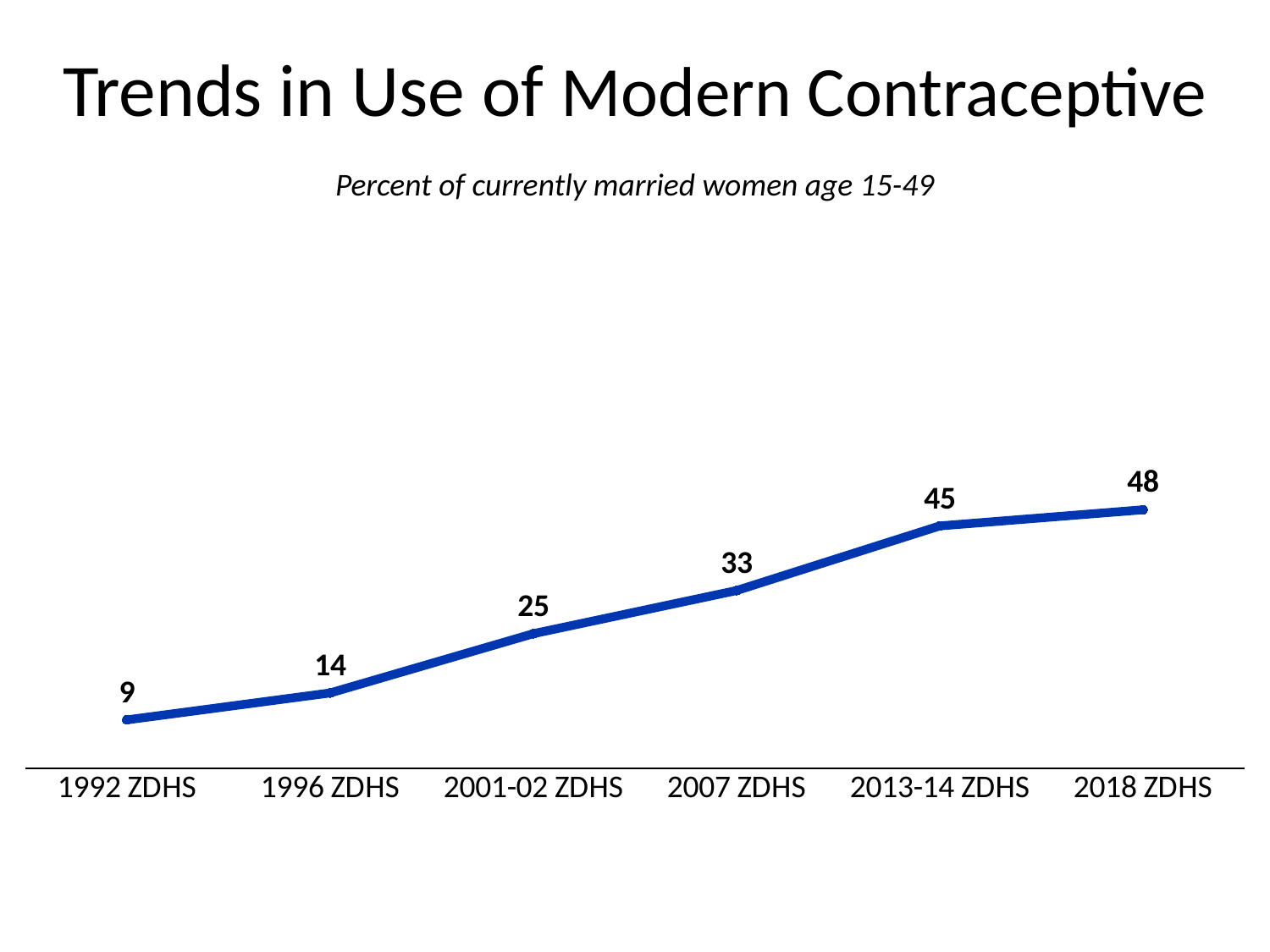
What is the value for 2001-02 ZDHS? 25 What is the value for 2018 ZDHS? 48 What is the value for 1992 ZDHS? 9 What kind of chart is shown on the slide? Line chart What is the difference between the values for 2013-14 ZDHS and 2007 ZDHS? 12 What is the value for 2007 ZDHS? 33 How many surveys are plotted on the chart? 6 What is the difference between the values for 2018 ZDHS and 1992 ZDHS? 39 Which survey has the highest value? 2018 ZDHS Which is larger, the value for 1996 ZDHS or the value for 2001-02 ZDHS? 2001-02 ZDHS Do the values rise or fall from 1992 ZDHS to 2018 ZDHS? Rise Which survey has the lowest value? 1992 ZDHS